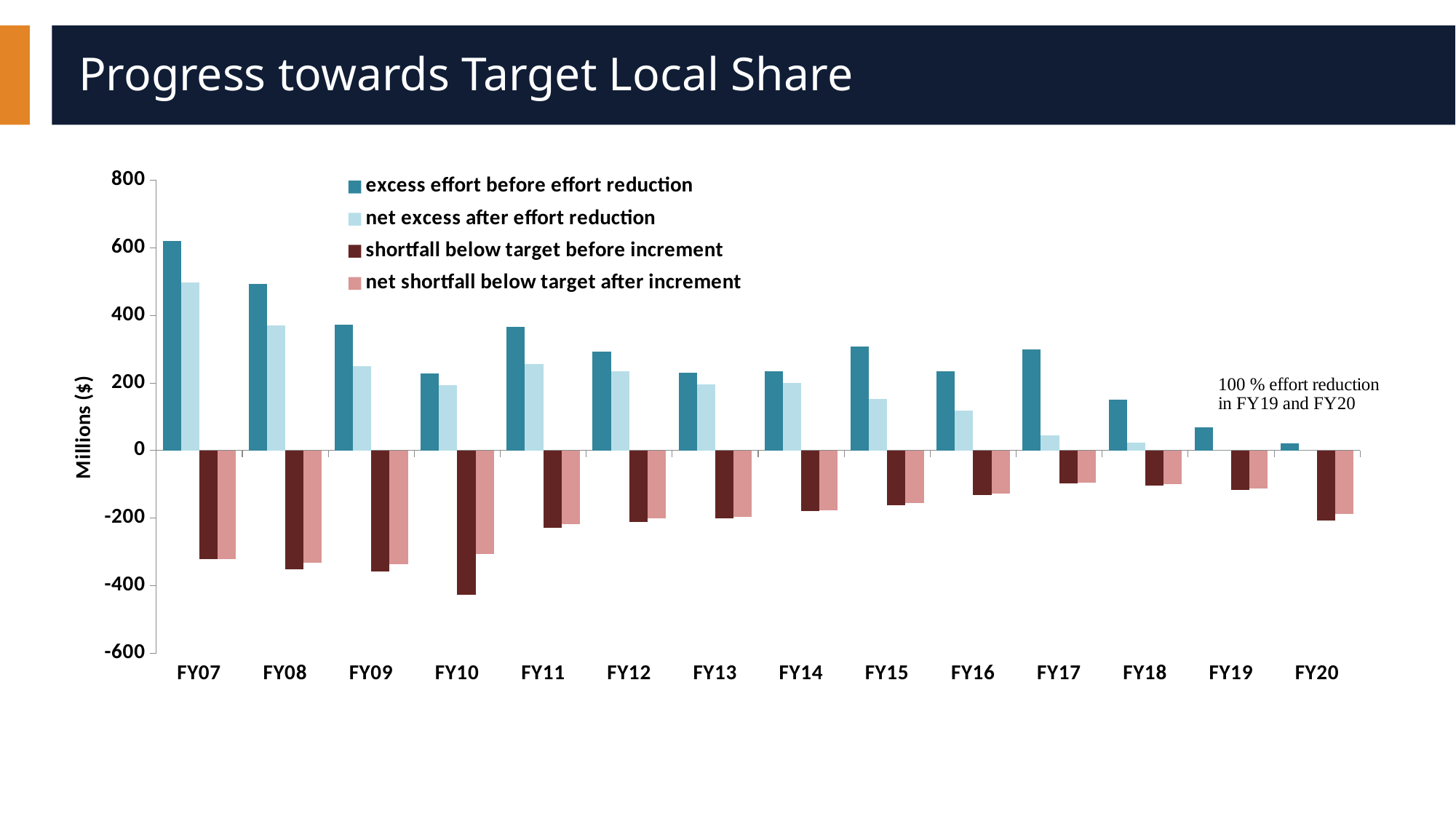
Is the value for shortfall below target before increment in FY10 greater or less than -400? less How many fiscal years are shown on the x axis? 14 What kind of chart is shown on the slide? bar chart Does the net excess after effort reduction generally rise or fall from FY07 to FY20? fall Which fiscal year has the lowest (most negative) value for shortfall below target before increment? FY10 Which fiscal year has the highest value for excess effort before effort reduction? FY07 Is the value for excess effort before effort reduction in FY18 greater or less than 200? less Is the value for net excess after effort reduction in FY07 greater or less than 400? greater Which fiscal year has the lowest value for excess effort before effort reduction? FY20 What is the label on the y axis? Millions ($) How many series does the legend list? 4 Which is larger, the excess effort before effort reduction in FY07 or in FY08? FY07